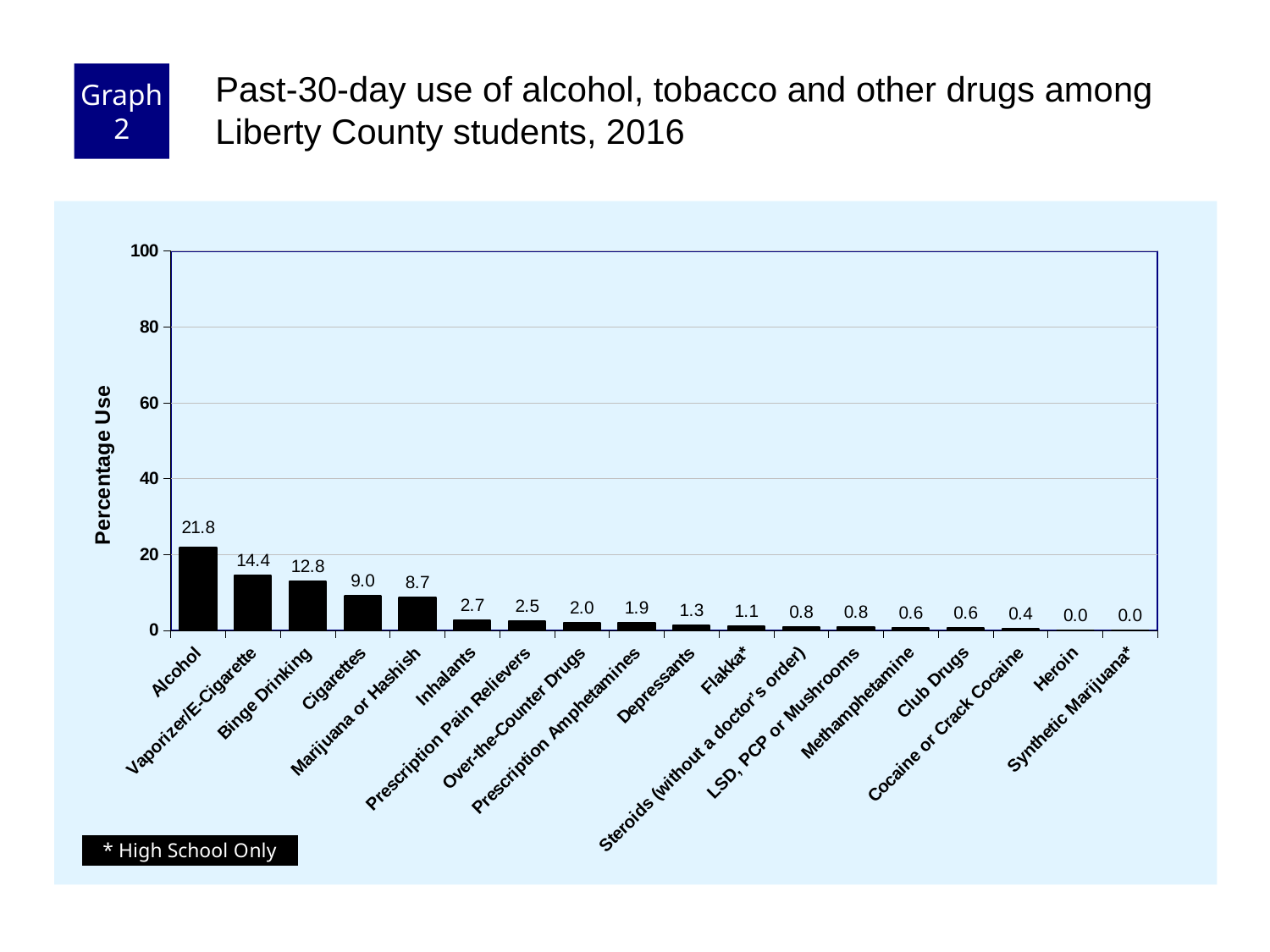
What kind of chart is shown on the slide? bar chart Which category has the highest percentage use? Alcohol What is the percentage use for Alcohol? 21.8 What is the label of the y axis? Percentage Use Which has a higher percentage use, Cigarettes or Marijuana or Hashish? Cigarettes What is the percentage use for Inhalants? 2.7 What is the percentage use for Vaporizer/E-Cigarette? 14.4 Is the value for Vaporizer/E-Cigarette greater or less than 20? less What is the difference in percentage use between Alcohol and Binge Drinking? 9.0 How many categories are shown on the x axis? 18 Do the values rise or fall moving left to right along the x axis? fall What is the percentage use for Marijuana or Hashish? 8.7